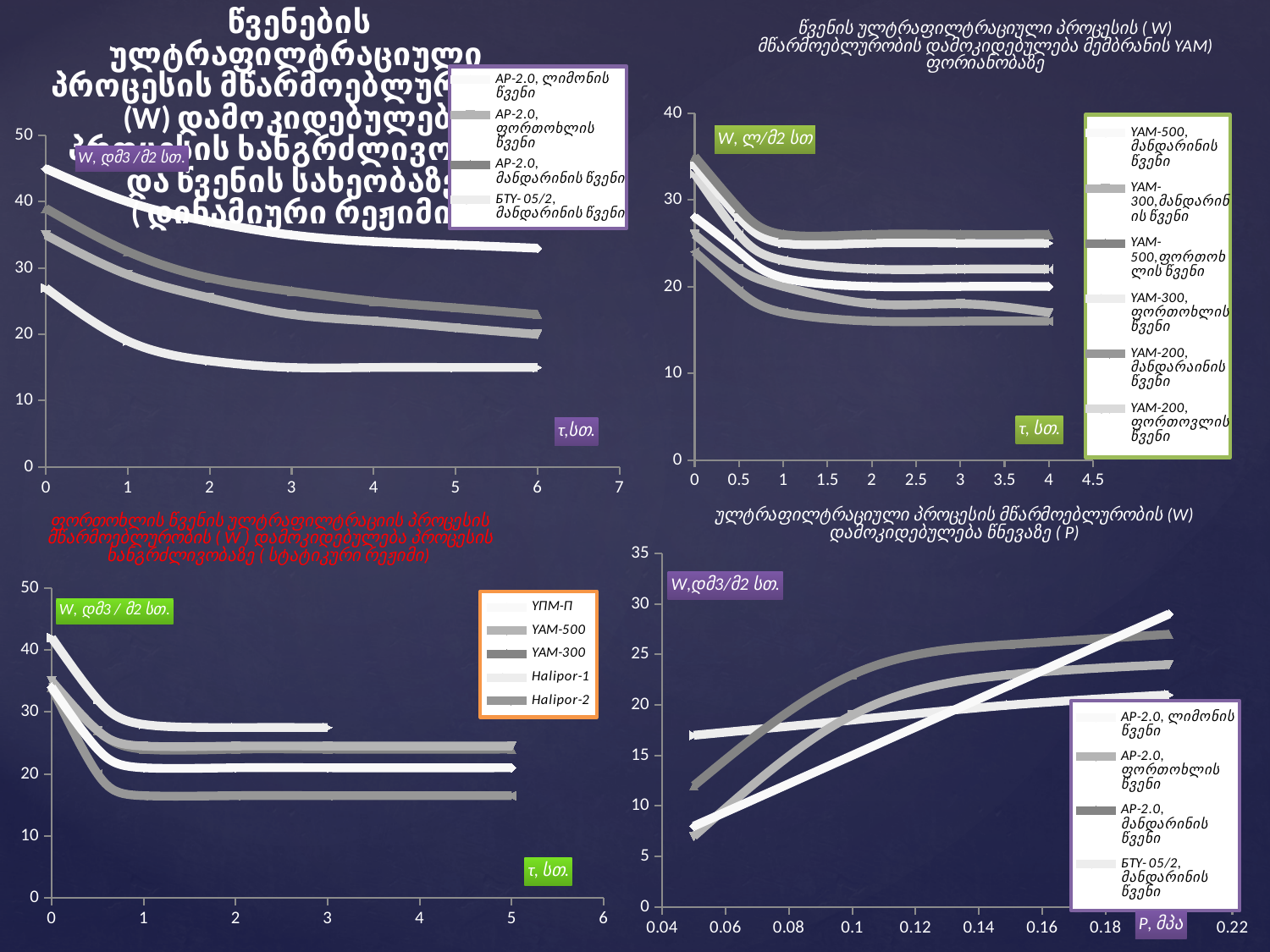
What kind of chart is the top-left chart on the slide? line chart How many series does the legend of the bottom-right chart list? 4 In the bottom-right chart (dependence on pressure P), do the values rise or fall as P increases? rise How many series does the legend of the bottom-left chart (static regime) list? 5 How many series does the legend of the top-left chart list? 4 In the top-right chart, is the lowest value at τ = 4 greater or less than 20? less In the top-left chart, is the highest value at τ = 0 greater or less than 40? greater In the top-left chart, do the values rise or fall as τ increases? fall In the bottom-left chart, do the values rise or fall as τ increases from 0? fall What is the y-axis label shown on the top-right chart? W, ლ/მ2 სთ What is the x-axis label shown on the bottom-right chart? P, მპა